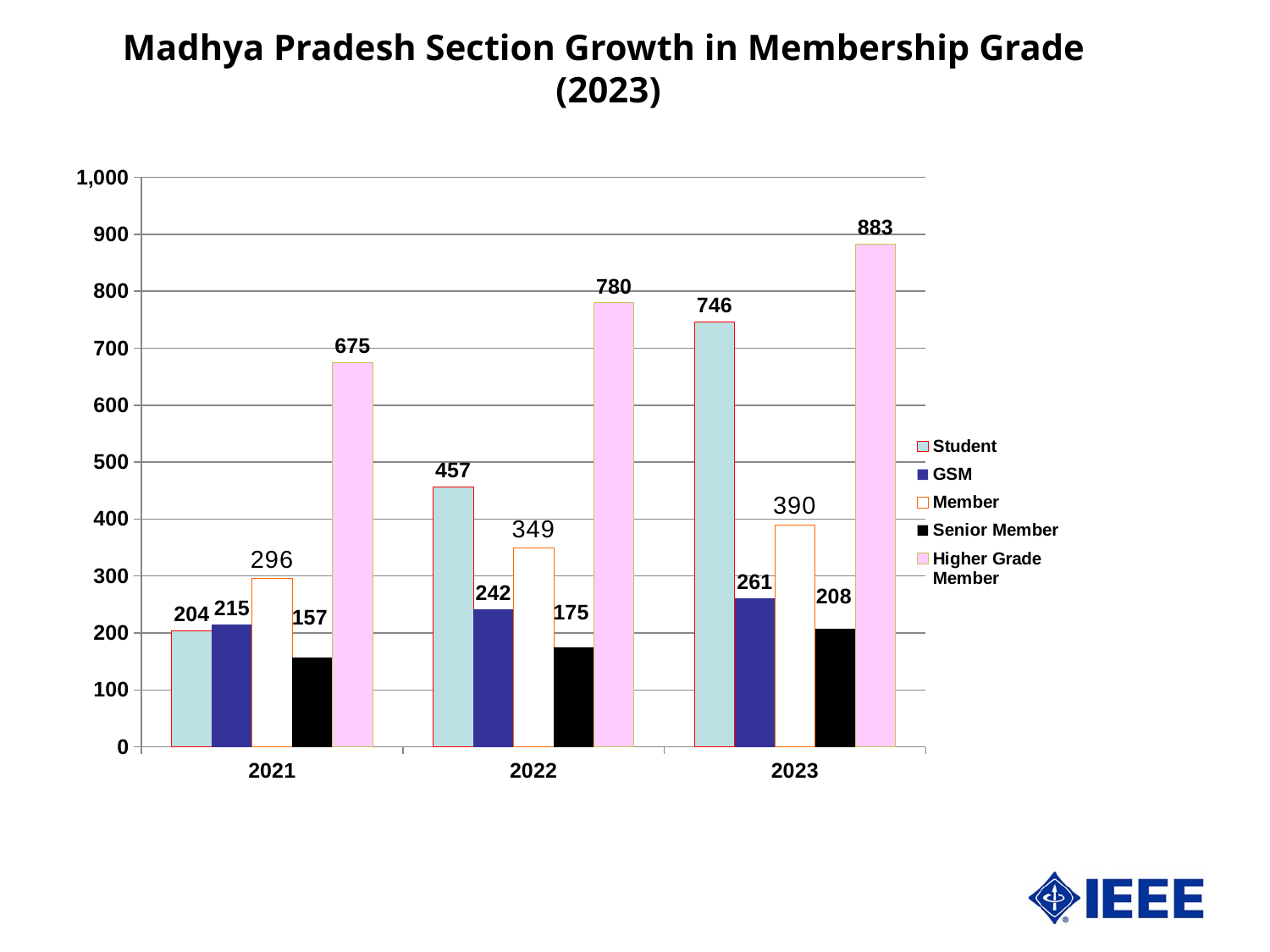
Which series has the highest value in 2023? Higher Grade Member Do the Student values rise or fall from 2021 to 2023? rise How many years are shown on the x axis? 3 Is the value for GSM in 2023 greater or less than 300? less How many series does the legend list? 5 What is the value for Student in 2023? 746 What kind of chart is shown? bar chart What is the value for Higher Grade Member in 2021? 675 What is the difference between the Higher Grade Member values for 2023 and 2022? 103 What is the value for Senior Member in 2022? 175 Which series has the lowest value in 2021? Senior Member Which is larger, the Student value in 2022 or the Member value in 2022? Student